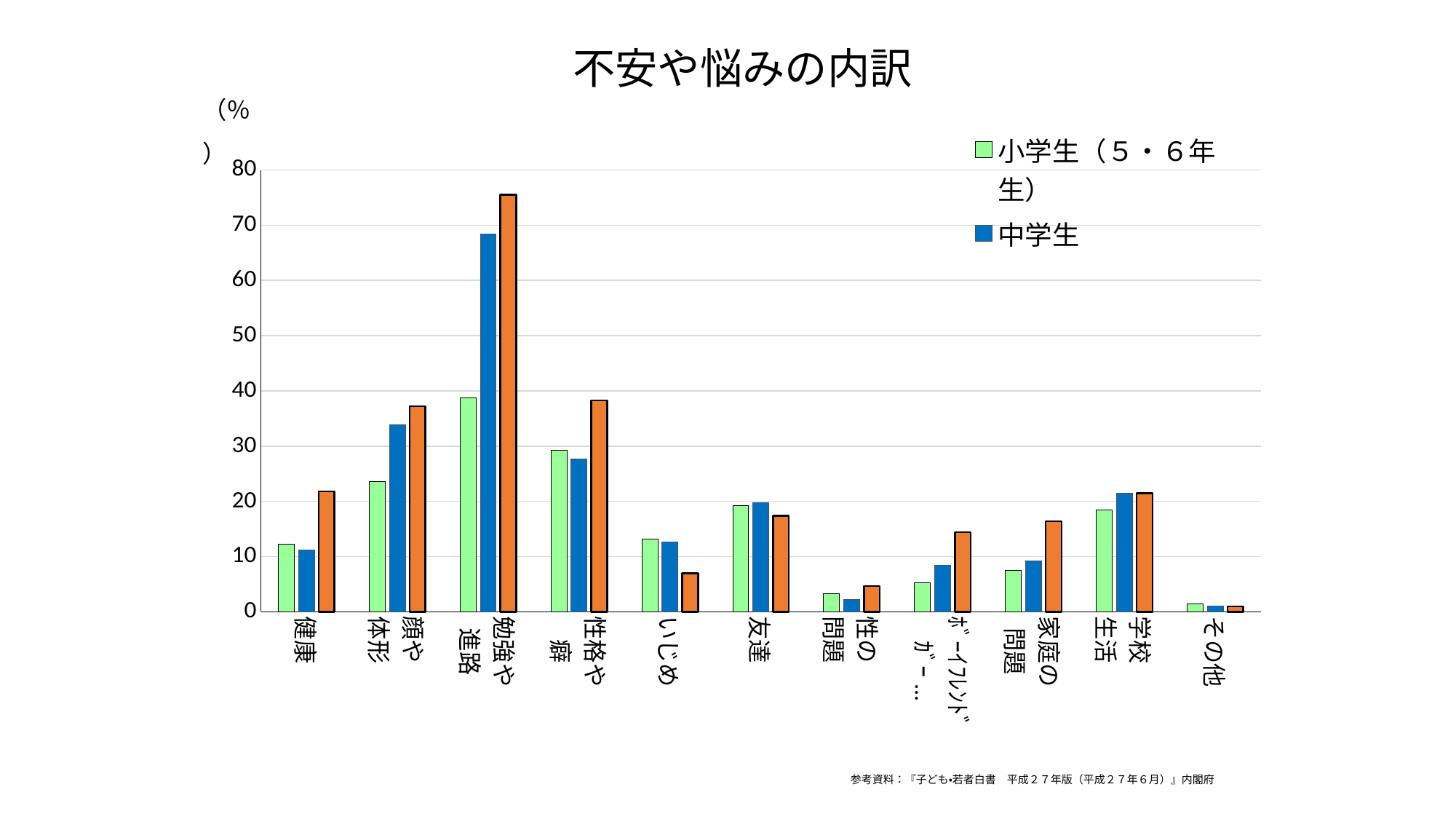
Is the value for 中学生 in 進路や勉強 greater or less than 60? greater Which category has the highest value for 中学生? 勉強や進路 Is the value for 小学生（５・６年生） in 健康 greater or less than 10? greater What is the title of the chart? 不安や悩みの内訳 How many series does the legend list? 2 What colour represents 中学生 in the legend? blue Which category has the lowest value for 小学生（５・６年生）? その他 Is the value for 中学生 in 体形や顔 greater or less than 30? greater In 体形や顔, which is larger: the value for 小学生（５・６年生） or for 中学生? 中学生 What kind of chart is shown on the slide? bar chart How many categories are shown on the x axis? 11